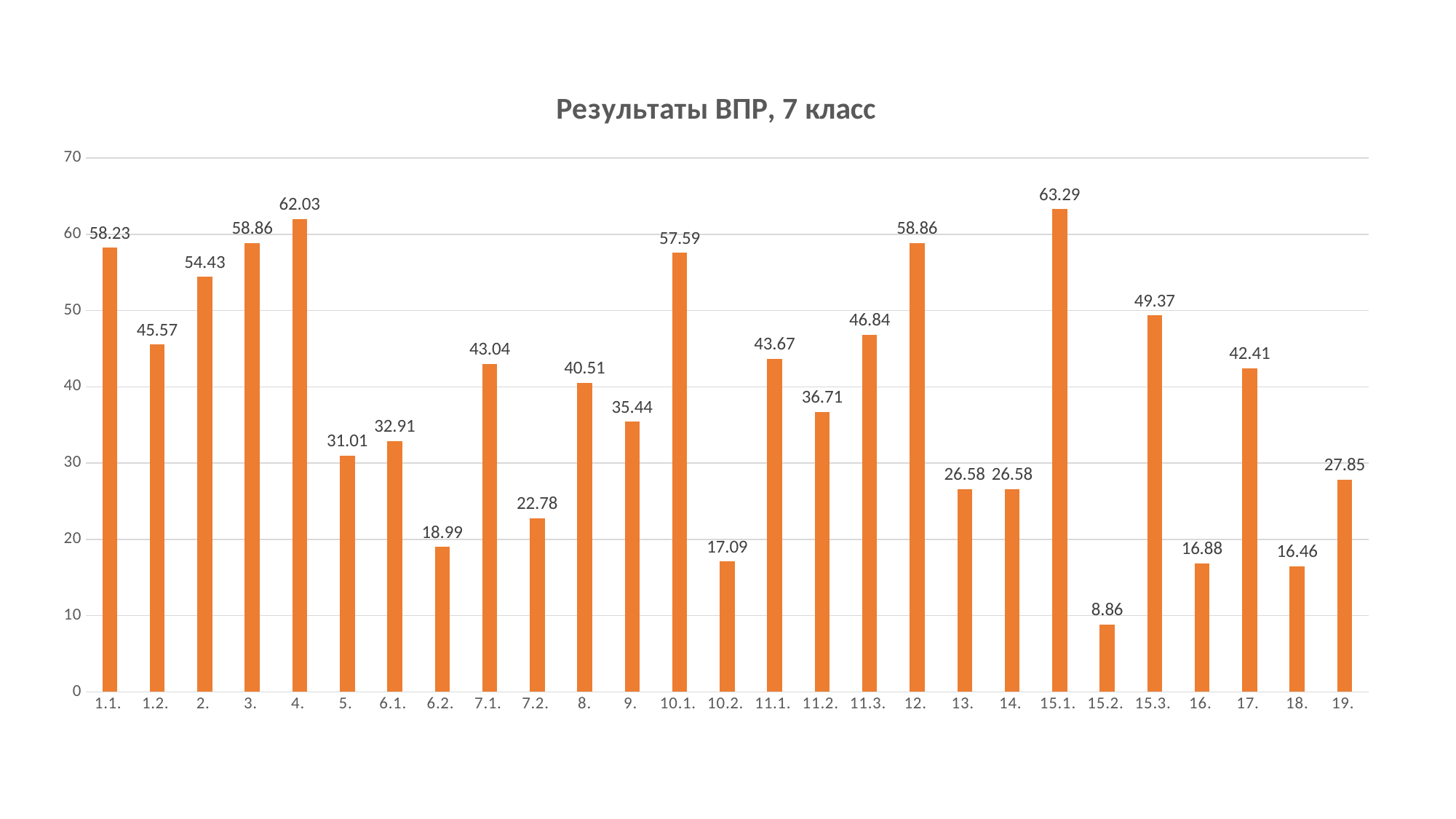
What is the title of the chart? Результаты ВПР, 7 класс Which is larger, the value for 7.1. or the value for 11.1.? 11.1. What is the value for category 4.? 62.03 What is the value for category 15.3.? 49.37 What is the value for category 10.2.? 17.09 What kind of chart is shown on the slide? bar chart What is the difference between the values for 15.3. and 15.2.? 40.51 Which category has the highest value? 15.1. Is the value for 9. greater or less than 30? greater Which category has the lowest value? 15.2. How many categories are shown on the x axis? 27 What is the difference between the values for 4. and 1.1.? 3.80